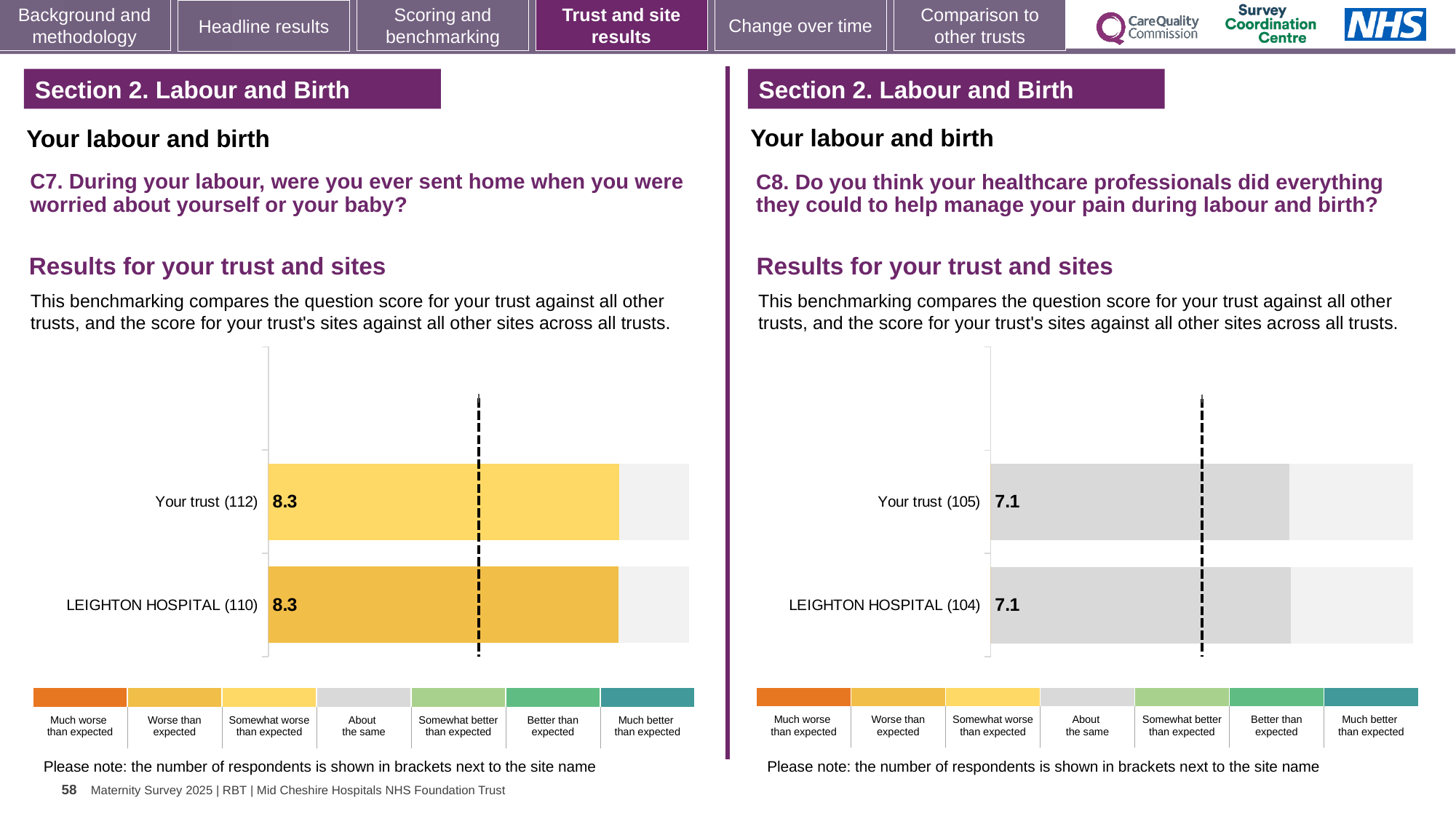
On the left chart (C7), how many respondents are shown in brackets for LEIGHTON HOSPITAL? 110 On the right chart (C8), what is the difference between the score for Your trust and the score for LEIGHTON HOSPITAL? 0 How many bars are plotted on the right chart (C8)? 2 On the right chart (C8), what is the score for Your trust? 7.1 On the left chart (C7), what is the difference between the score for Your trust and the score for LEIGHTON HOSPITAL? 0 On the right chart (C8), what is the score for LEIGHTON HOSPITAL? 7.1 How many bars are plotted on the left chart (C7)? 2 On the left chart (C7), what is the score for Your trust? 8.3 On the right chart (C8), which benchmark category does the grey colour of the bars correspond to in the legend? About the same What type of chart is used on the left (C7)? Bar chart On the left chart (C7), what is the score for LEIGHTON HOSPITAL? 8.3 On the right chart (C8), how many respondents are shown in brackets for Your trust? 105